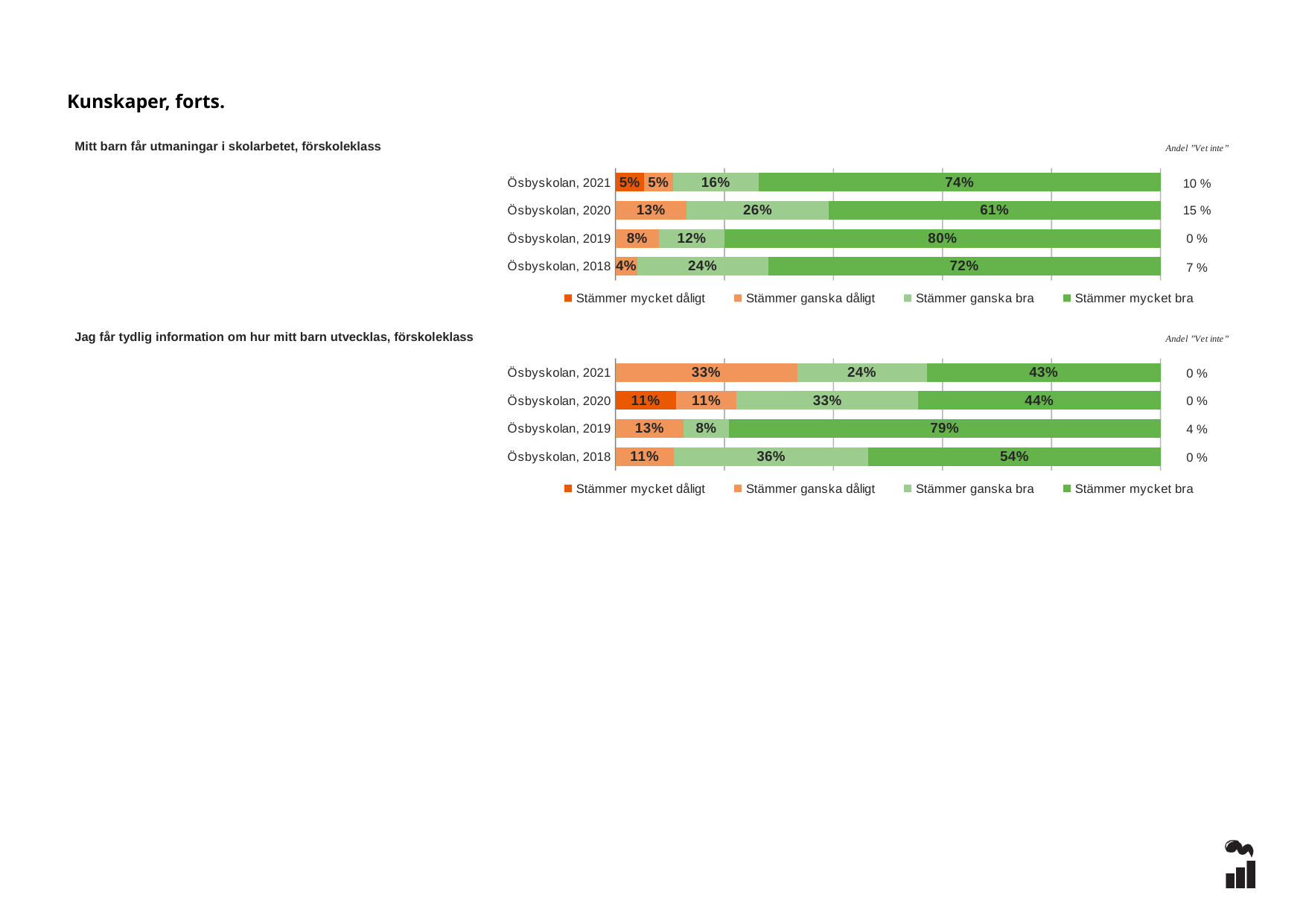
In the chart 'Mitt barn får utmaningar i skolarbetet, förskoleklass', what is the value of 'Stämmer mycket bra' for Ösbyskolan, 2019? 80% What kind of chart is 'Jag får tydlig information om hur mitt barn utvecklas, förskoleklass'? Stacked bar chart In the chart 'Mitt barn får utmaningar i skolarbetet, förskoleklass', what is the 'Andel "Vet inte"' value for Ösbyskolan, 2020? 15 % In the chart 'Mitt barn får utmaningar i skolarbetet, förskoleklass', how many series does the legend list? 4 In the chart 'Jag får tydlig information om hur mitt barn utvecklas, förskoleklass', how many bars (years) are shown? 4 In the chart 'Jag får tydlig information om hur mitt barn utvecklas, förskoleklass', is the 'Stämmer ganska bra' value larger for Ösbyskolan, 2018 or Ösbyskolan, 2019? Ösbyskolan, 2018 In the chart 'Mitt barn får utmaningar i skolarbetet, förskoleklass', what is the difference between the 'Stämmer mycket bra' values for Ösbyskolan, 2021 and Ösbyskolan, 2020? 13% In the chart 'Jag får tydlig information om hur mitt barn utvecklas, förskoleklass', what is the value of 'Stämmer ganska dåligt' for Ösbyskolan, 2021? 33% In the chart 'Jag får tydlig information om hur mitt barn utvecklas, förskoleklass', which year has the lowest 'Stämmer mycket bra' value? Ösbyskolan, 2021 In the chart 'Mitt barn får utmaningar i skolarbetet, förskoleklass', which year has the highest 'Stämmer mycket bra' value? Ösbyskolan, 2019 In the chart 'Jag får tydlig information om hur mitt barn utvecklas, förskoleklass', what is the 'Andel "Vet inte"' value for Ösbyskolan, 2019? 4 % In the chart 'Mitt barn får utmaningar i skolarbetet, förskoleklass', what is the value of 'Stämmer ganska bra' for Ösbyskolan, 2020? 26%